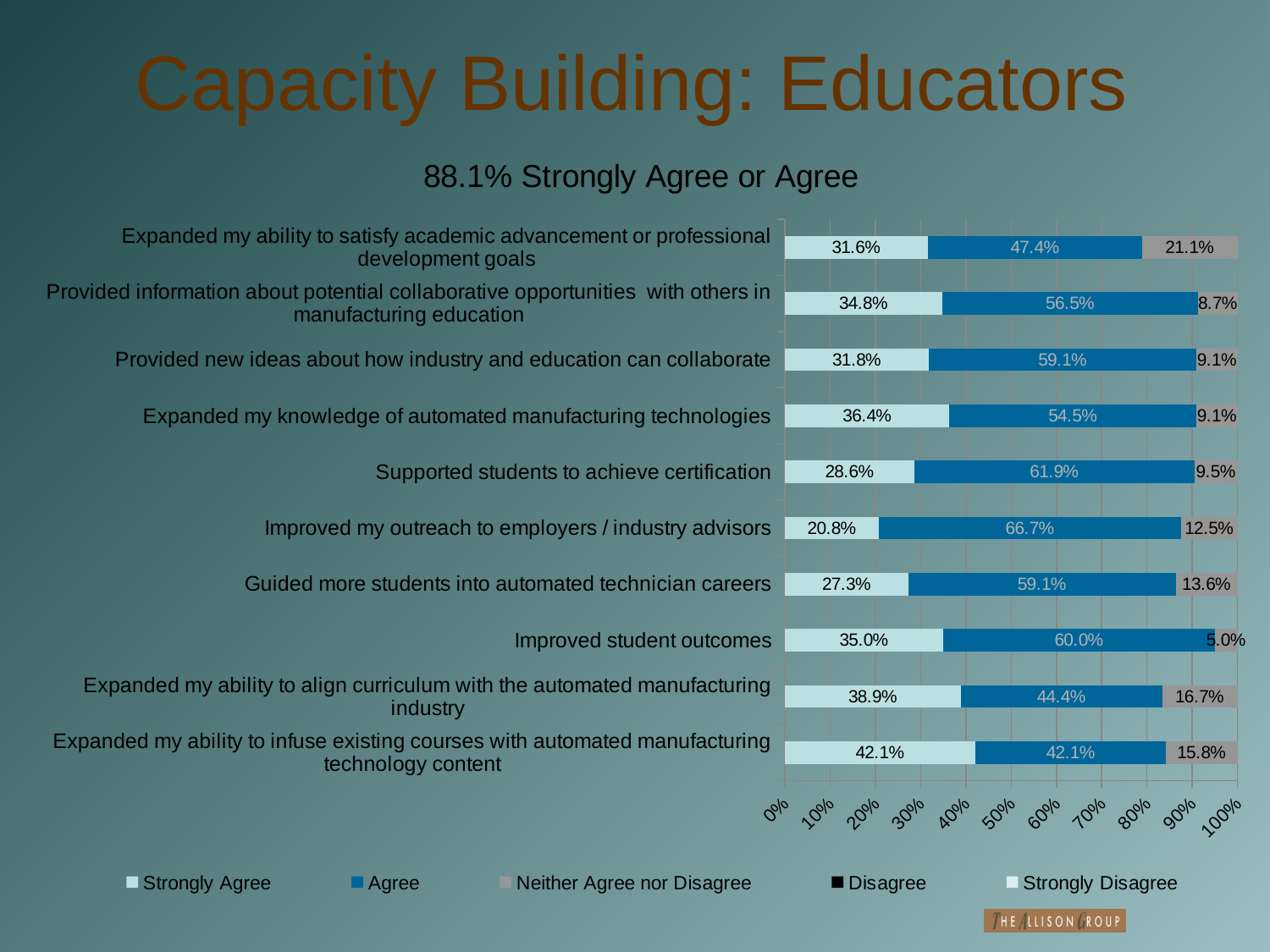
What is the subtitle shown above the chart? 88.1% Strongly Agree or Agree Which statement has the lowest Neither Agree nor Disagree percentage? Improved student outcomes What is the Agree value for "Improved my outreach to employers / industry advisors"? 66.7% Which is larger: the Strongly Agree value for "Expanded my knowledge of automated manufacturing technologies" or for "Supported students to achieve certification"? Expanded my knowledge of automated manufacturing technologies What is the difference between the Agree value for "Improved my outreach to employers / industry advisors" and the Agree value for "Expanded my ability to align curriculum with the automated manufacturing industry"? 22.3 percentage points Which statement has the highest Strongly Agree percentage? Expanded my ability to infuse existing courses with automated manufacturing technology content What percentage of educators selected Strongly Agree for "Improved student outcomes"? 35.0% What kind of chart is shown on the slide? Stacked bar chart How many response categories does the legend list? 5 Which statement has the lowest Strongly Agree percentage? Improved my outreach to employers / industry advisors What is the Neither Agree nor Disagree value for "Expanded my ability to satisfy academic advancement or professional development goals"? 21.1% How many statements (categories) are shown in the chart? 10